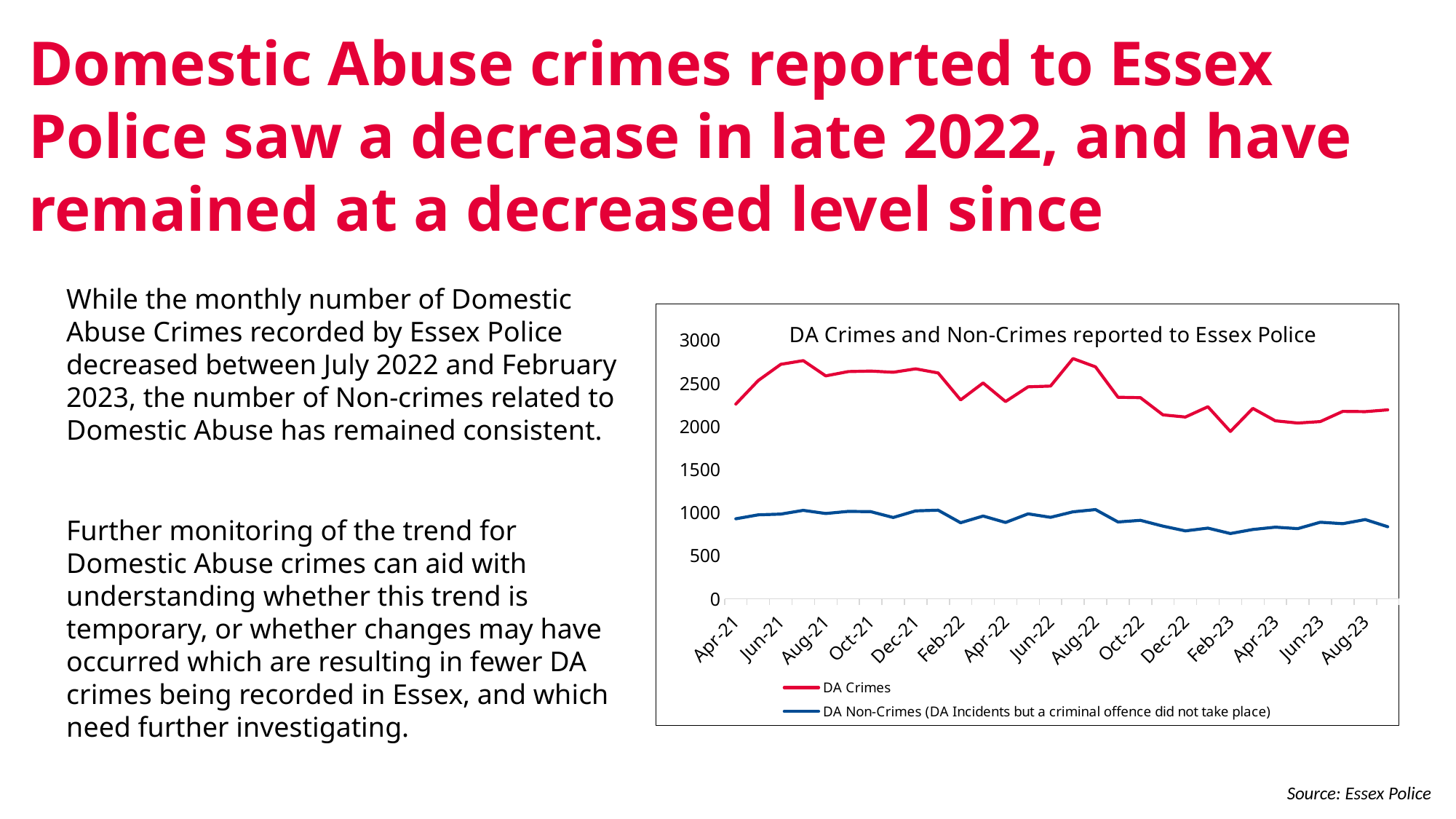
Which series has the higher value in Aug-22, DA Crimes or DA Non-Crimes? DA Crimes Is the value for DA Non-Crimes in Apr-21 greater or less than 1500? less Which series is higher across the whole period shown? DA Crimes Is the value for DA Crimes in Aug-22 greater or less than 2500? greater What kind of chart is shown on the slide? Line chart What is the title of the chart? DA Crimes and Non-Crimes reported to Essex Police Is the value for DA Crimes in Dec-22 greater or less than 2500? less Which colour is used for the DA Crimes line? Red Do DA Crimes rise or fall between Aug-22 and Feb-23? Fall How many series does the chart's legend list? 2